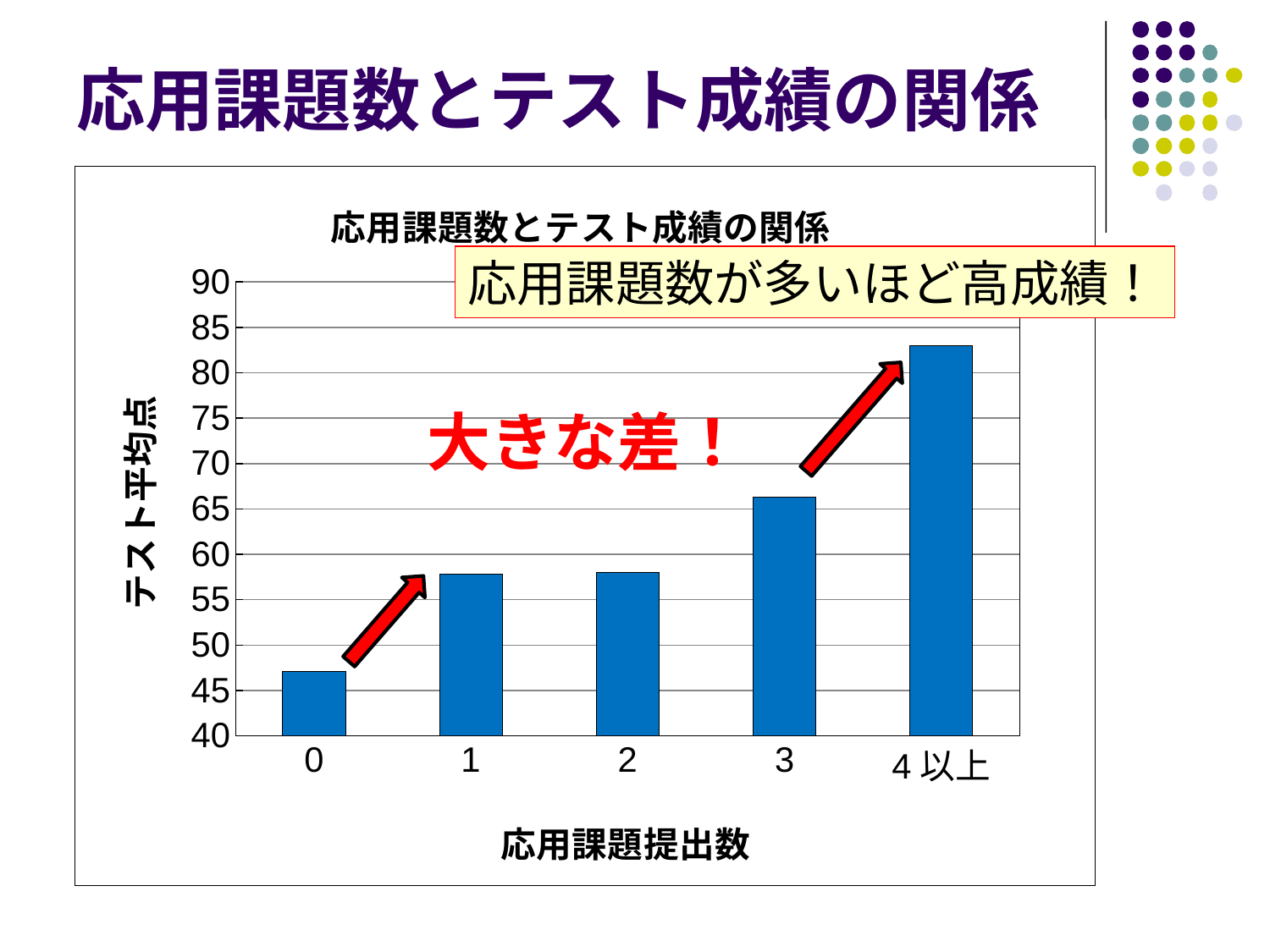
Which category has the lowest テスト平均点? 0 Is the value for category 1 greater or less than 60? less What kind of chart is shown on the slide? bar chart Which category has the highest テスト平均点? 4以上 Do the values generally rise or fall as 応用課題提出数 increases along the x axis? rise What is the title of the chart? 応用課題数とテスト成績の関係 What is the label of the y axis? テスト平均点 How many categories are shown on the x axis of the chart? 5 Which has a higher テスト平均点, category 0 or category 3? 3 Is the value for category 4以上 greater or less than 80? greater Is the value for category 0 greater or less than 50? less